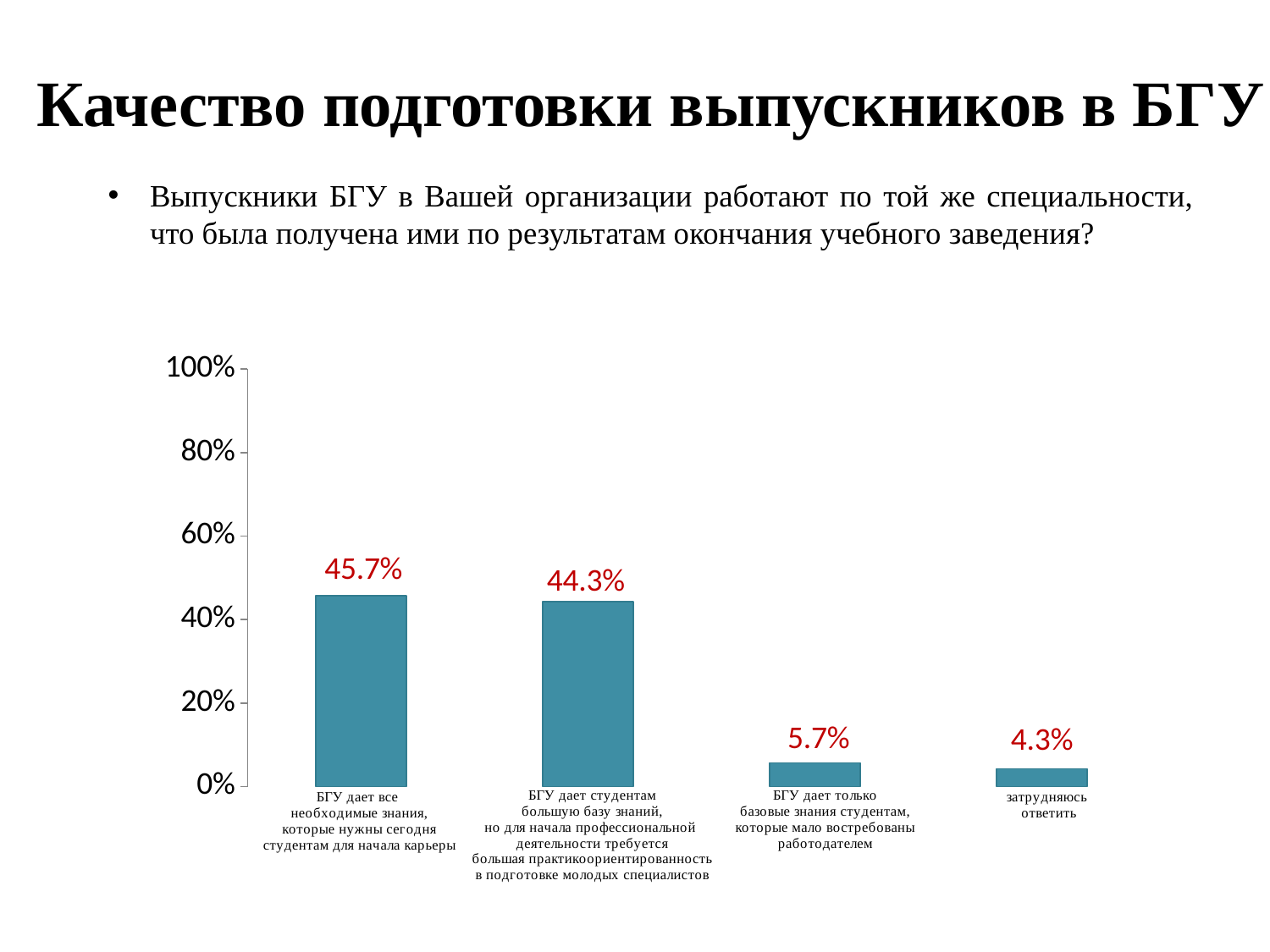
What is the value for the category "БГУ дает только базовые знания студентам, которые мало востребованы работодателем"? 5.7% What is the maximum value shown on the vertical axis? 100% Is the value for "БГУ дает студентам большую базу знаний..." greater or less than 60%? less What is the value for the category "БГУ дает все необходимые знания, которые нужны сегодня студентам для начала карьеры"? 45.7% What kind of chart is shown on the slide? bar chart How many categories are shown in the chart? 4 Which is larger: the value for "БГУ дает только базовые знания..." or the value for "затрудняюсь ответить"? БГУ дает только базовые знания... Which category has the lowest value? затрудняюсь ответить What is the difference between the values for "БГУ дает все необходимые знания..." (45.7%) and "БГУ дает студентам большую базу знаний..." (44.3%)? 1.4% Which category has the highest value? БГУ дает все необходимые знания, которые нужны сегодня студентам для начала карьеры What is the value for the category "затрудняюсь ответить"? 4.3% What is the difference between the values for "БГУ дает только базовые знания..." and "затрудняюсь ответить"? 1.4%